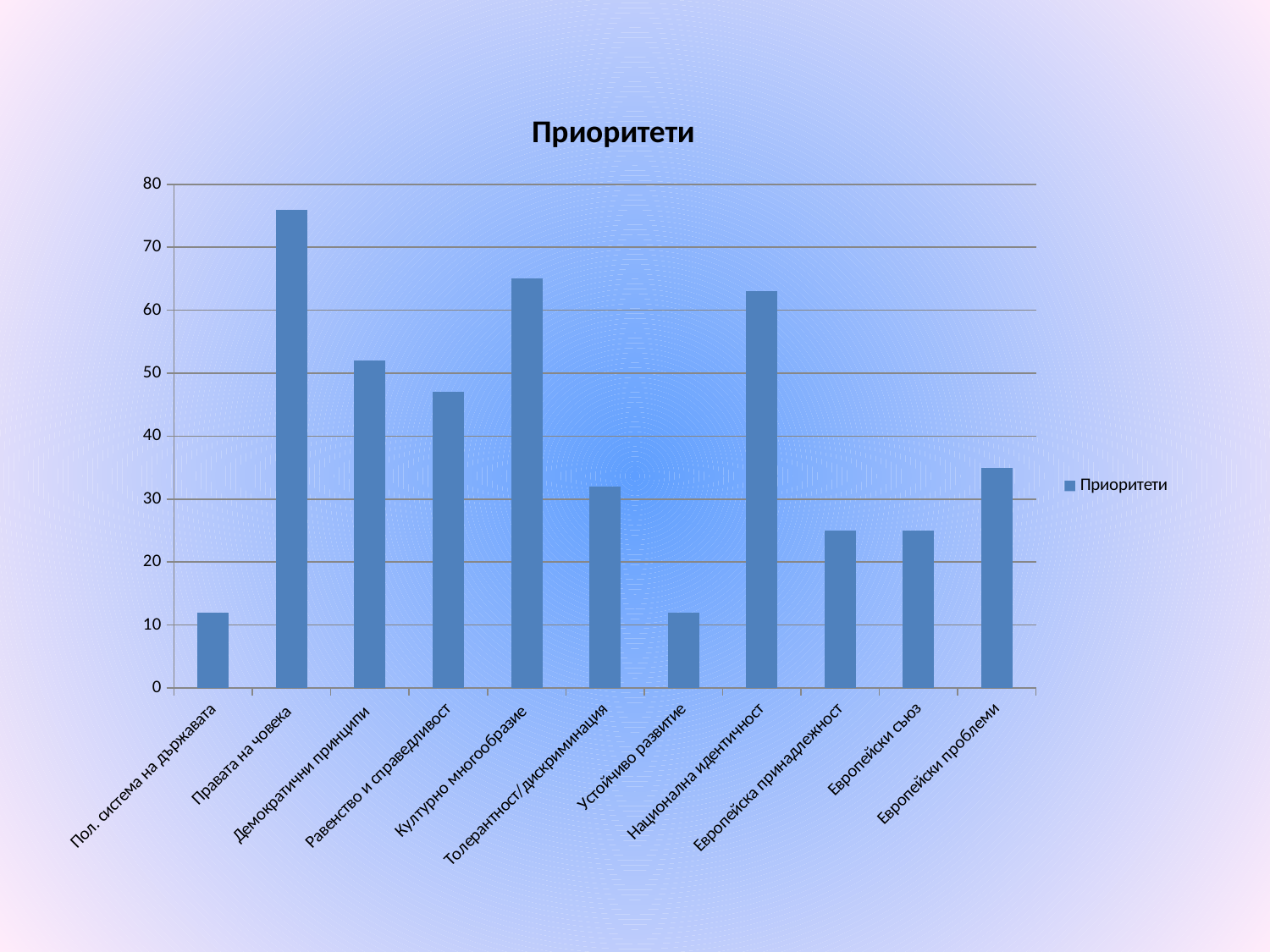
What kind of chart is shown on the slide? bar chart What is the title of the chart? Приоритети Is the value for Европейски проблеми greater or less than 40? less Which is larger, the value for Демократични принципи or the value for Европейски проблеми? Демократични принципи Is the value for Национална идентичност greater or less than 60? greater Is the value for Правата на човека greater or less than 70? greater How many categories are shown on the x axis of the chart? 11 Which category has the highest value? Правата на човека Which is larger, the value for Културно многообразие or the value for Толерантност/дискриминация? Културно многообразие How many series does the legend list? 1